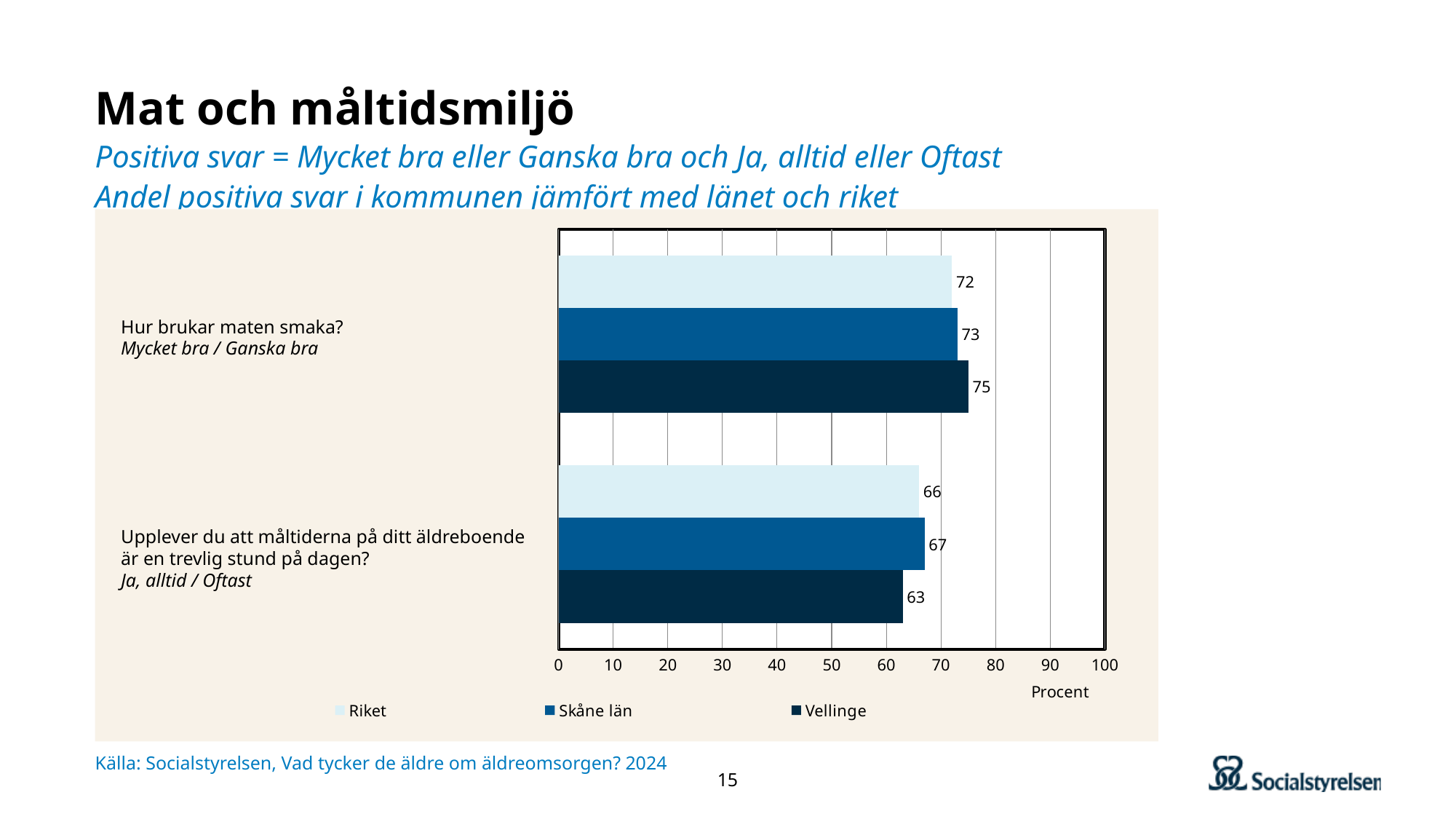
What kind of chart is shown on the slide? Bar chart Which series has the highest value for "Hur brukar maten smaka?"? Vellinge What is the value for Vellinge on the question "Hur brukar maten smaka?"? 75 Which is larger for "Upplever du att måltiderna på ditt äldreboende är en trevlig stund på dagen?": Skåne län or Vellinge? Skåne län What is the difference between the Vellinge values for the two questions? 12 How many series does the legend list? 3 How many questions (categories) are shown in the chart? 2 What unit is shown on the x axis of the chart? Procent What is the value for Riket on the question "Upplever du att måltiderna på ditt äldreboende är en trevlig stund på dagen?"? 66 Which series has the lowest value for "Upplever du att måltiderna på ditt äldreboende är en trevlig stund på dagen?"? Vellinge Is the value for Riket on "Hur brukar maten smaka?" greater or less than 80? less What is the value for Skåne län on the question "Hur brukar maten smaka?"? 73